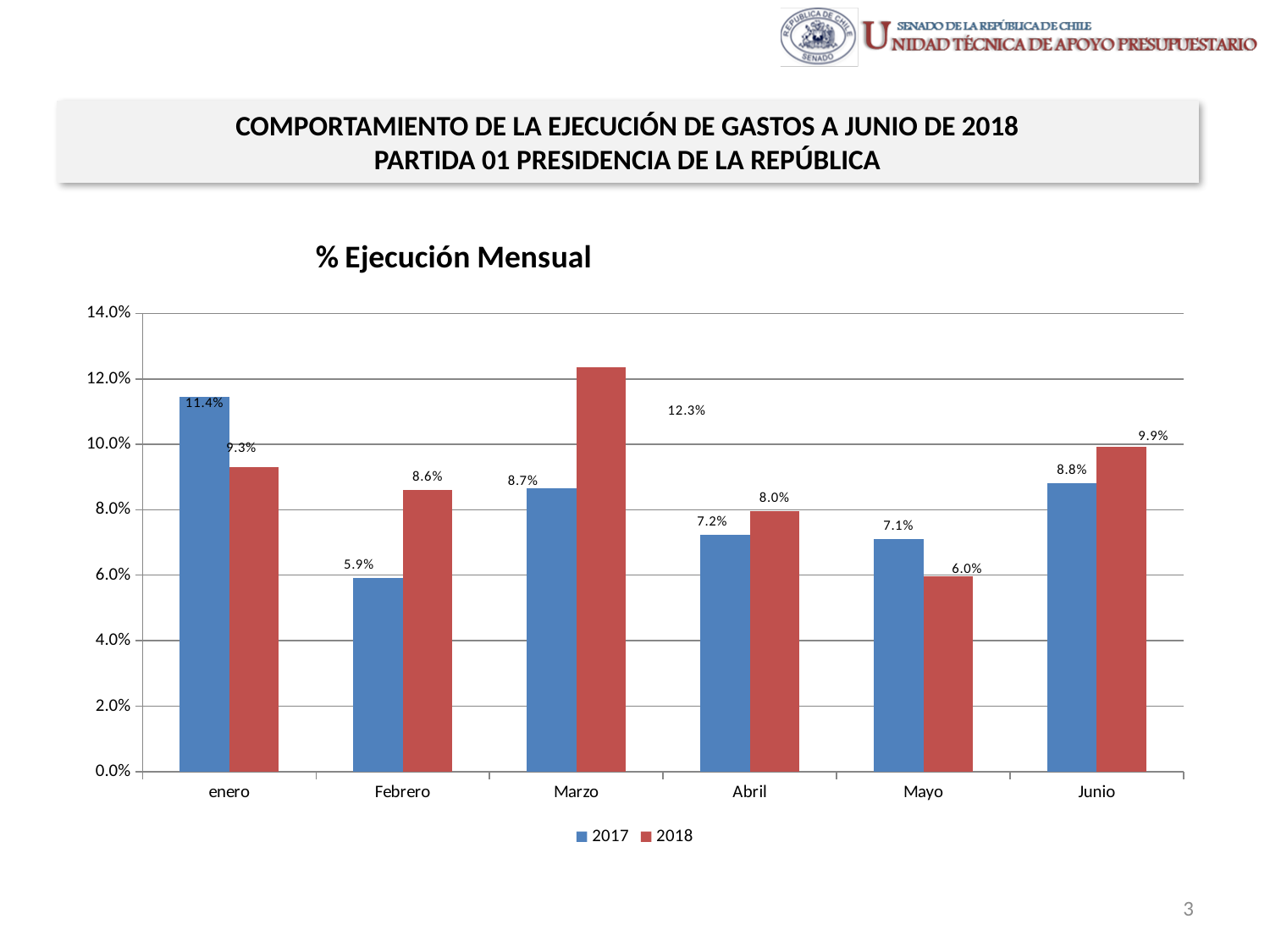
What is the value for 2017 in enero? 11.4% How many series does the legend list? 2 What is the value for 2018 in Marzo? 12.3% How many months are shown on the x axis? 6 Which month has the highest value for the 2018 series? Marzo What is the title of the chart? % Ejecución Mensual Is the value for 2018 in Junio greater or less than 8.0%? greater What type of chart is shown on the slide? bar chart What is the value for 2018 in Mayo? 6.0% Which month has the lowest value for the 2017 series? Febrero What is the difference between the 2018 and 2017 values in Febrero? 2.7% Which is larger in Mayo, the 2017 value or the 2018 value? 2017